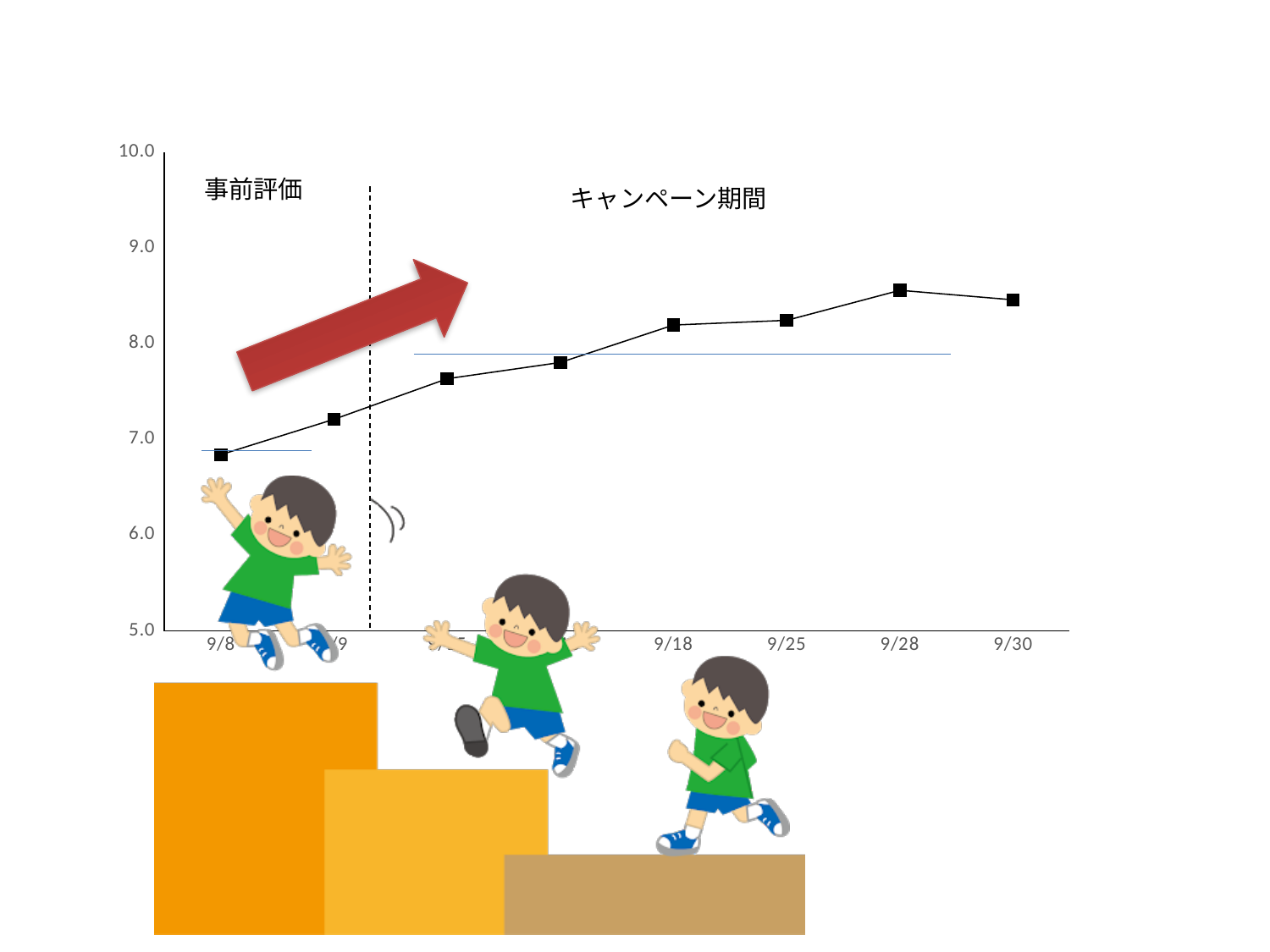
Do the plotted values generally rise or fall from 9/8 to 9/28? rise Is the value for 9/18 greater or less than 8.0? greater Is the value for 9/28 greater or less than 8.0? greater How many data points are plotted on the line? 8 What label is written above the chart to the right of the dashed vertical line? キャンペーン期間 What label is written above the chart to the left of the dashed vertical line? 事前評価 Which date has the lowest plotted value? 9/8 Which is larger, the value for 9/8 or the value for 9/30? 9/30 Which date has the highest plotted value? 9/28 Is the value for 9/30 greater or less than 9.0? less What kind of chart is shown on the slide? line chart